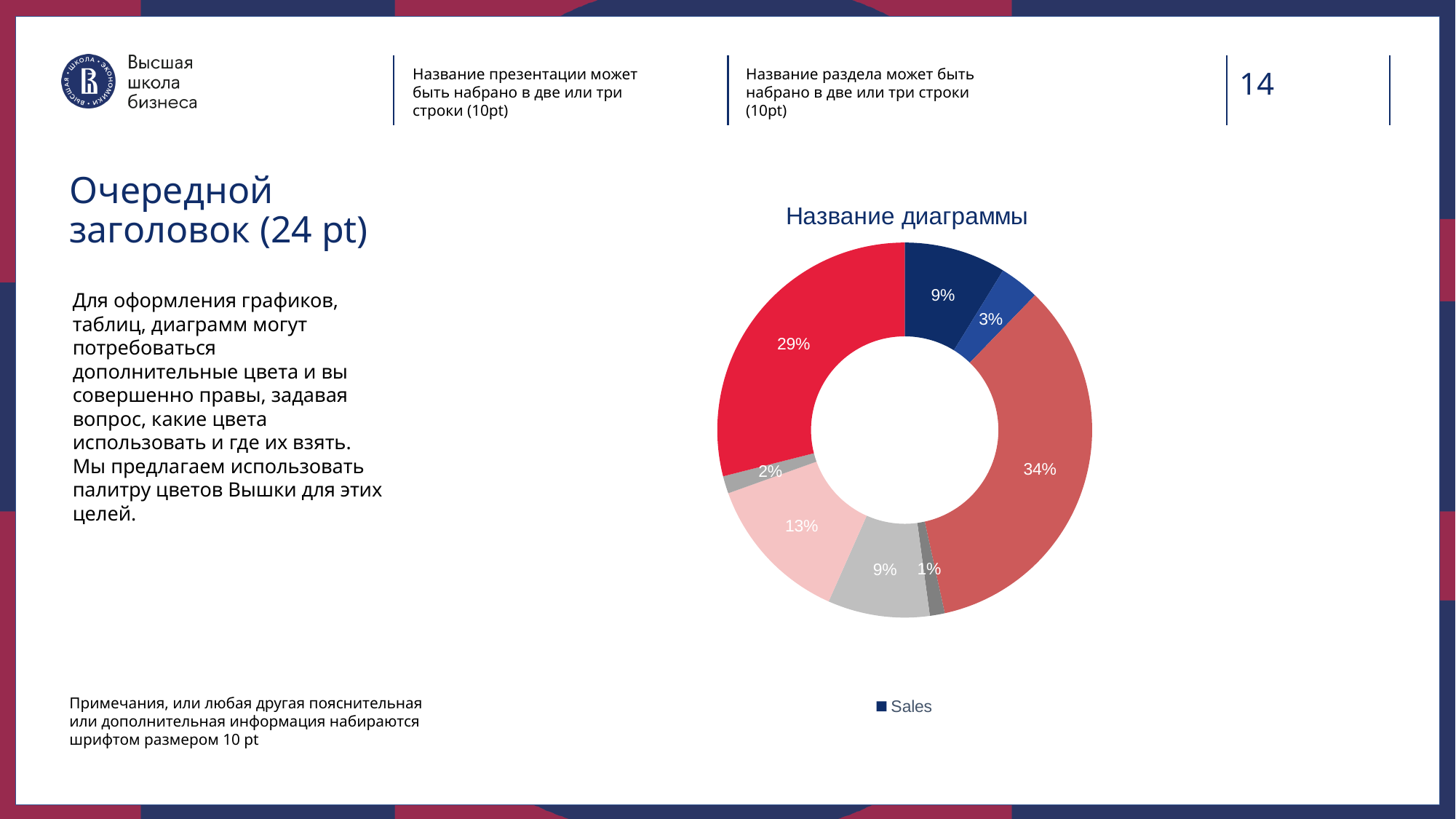
What is the difference between the largest slice (34%) and the bright red slice (29%)? 5% How many slices does the doughnut chart have? 8 What share is shown for the dark navy blue slice at the top of the doughnut chart? 9% What share is shown for the light pink slice of the doughnut chart? 13% What is the smallest share shown on the doughnut chart? 1% Which is larger: the light pink slice or the bright red slice? The bright red slice (29%) How many series does the legend list? 1 What kind of chart is shown on the slide? Doughnut (pie) chart What is the largest share shown on the doughnut chart? 34% What share is shown for the bright red slice of the doughnut chart? 29% What is the title of the chart? Название диаграммы What series name does the chart legend list? Sales